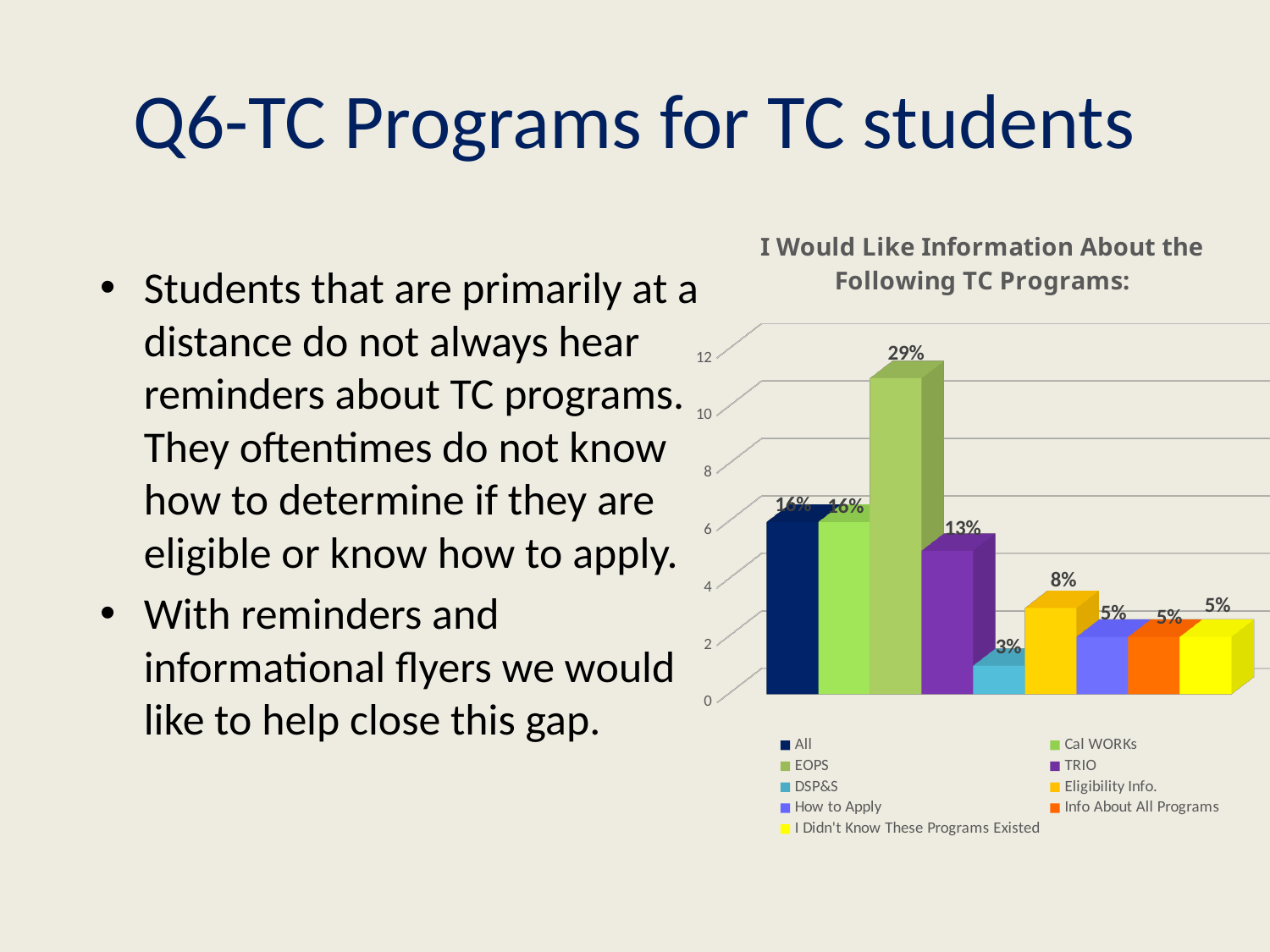
What is the title of the chart? I Would Like Information About the Following TC Programs: Which is larger, the value for Eligibility Info. or the value for How to Apply? Eligibility Info. Is the EOPS bar greater or less than 10 on the vertical axis? greater What is the data label shown for Eligibility Info. in the chart? 8% How many series does the legend list? 9 What kind of chart is shown on the slide? Bar chart Which program has the highest value in the chart? EOPS What is the data label shown for DSP&S in the chart? 3% What is the difference between the EOPS label and the TRIO label? 16% Which program has the lowest value in the chart? DSP&S What is the data label shown for EOPS in the chart? 29% What is the data label shown for TRIO in the chart? 13%